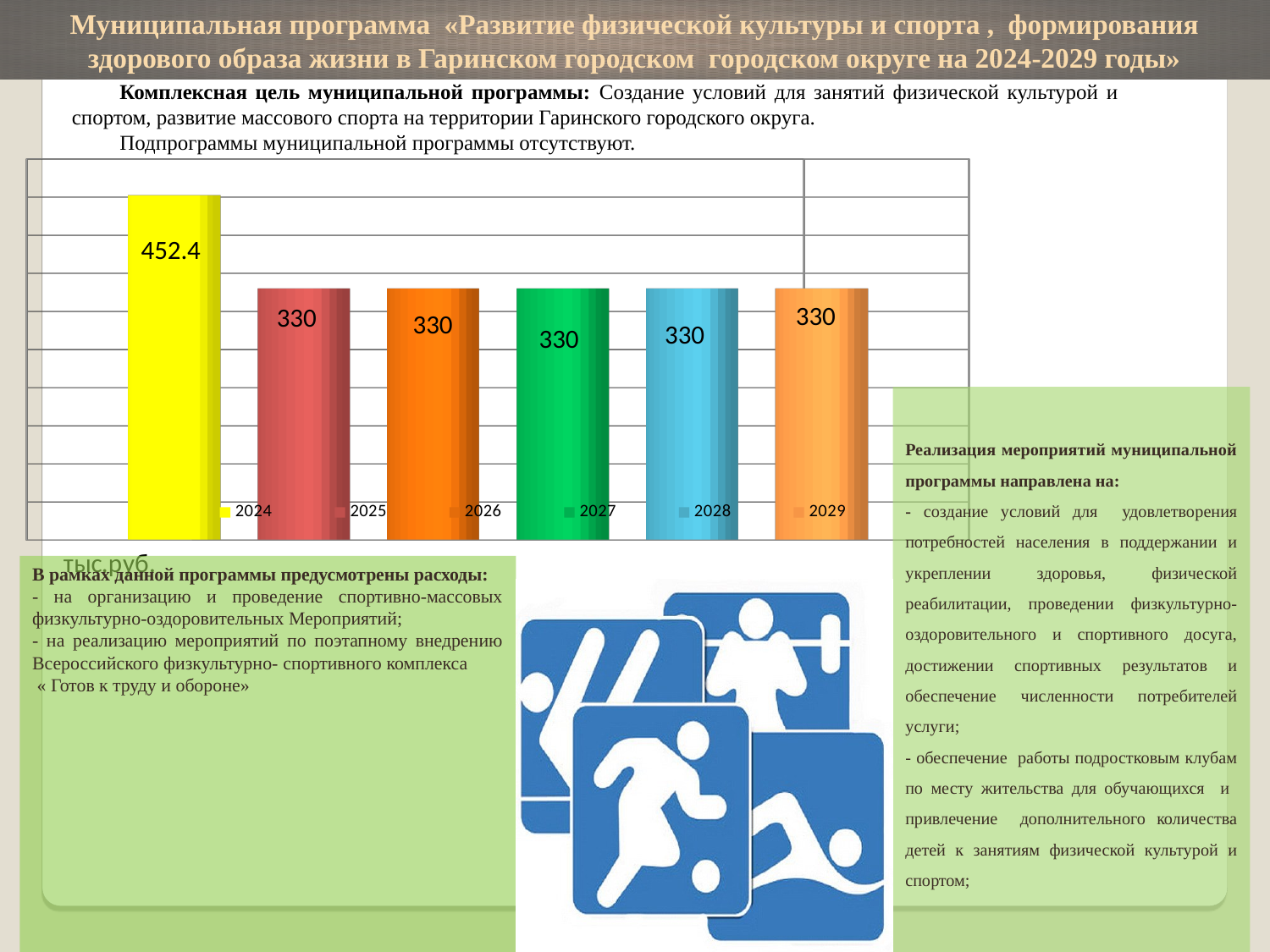
How many bars are shown in the chart? 6 What is the difference between the values for 2024 and 2025? 122.4 What is the value for 2025? 330 What is the value for 2027? 330 Does the value rise or fall from 2024 to 2025? fall What kind of chart is shown on the slide? bar chart What is the value for 2029? 330 What colour is the bar for 2024? yellow Which year has the highest value? 2024 What is the value for 2024? 452.4 Which is larger, the value for 2024 or the value for 2028? 2024 How many entries does the legend list? 6